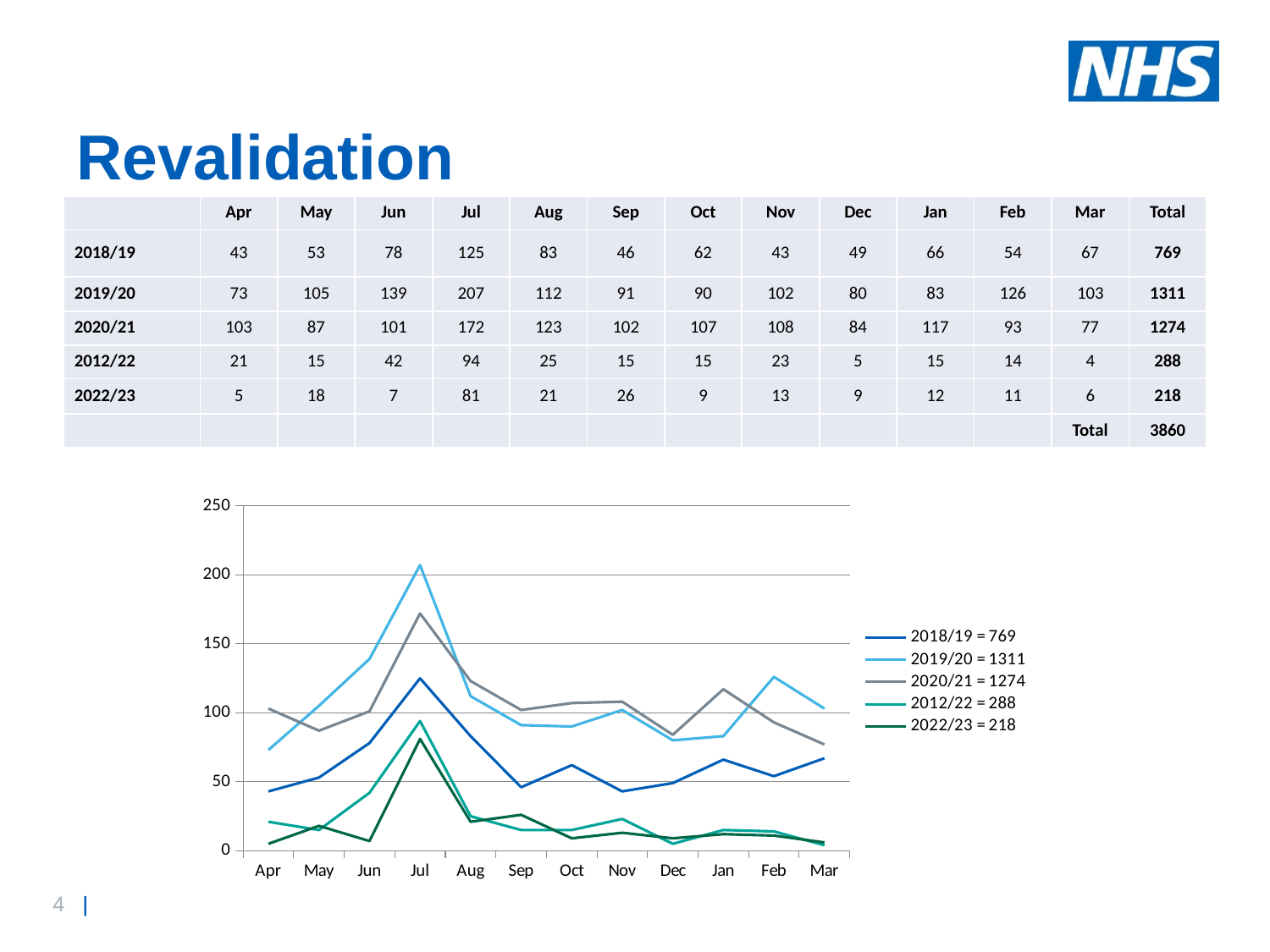
What kind of chart is shown on the slide? line chart What is the value for 2019/20 in Jul? 207 Is the value for 2019/20 in Jul greater or less than 200? greater Which series has the highest value in Jul? 2019/20 Is the value for 2022/23 in Jul greater or less than 100? less How many months are shown along the x axis of the chart? 12 How many series does the chart's legend list? 5 Which series has the lowest total according to the legend? 2022/23 What total does the legend give for the 2020/21 series? 1274 Does the 2019/20 line rise or fall from Jul to Sep? fall What is the difference between the Jul values for 2019/20 and 2020/21? 35 In Jan, which is larger: the value for 2020/21 or the value for 2019/20? 2020/21